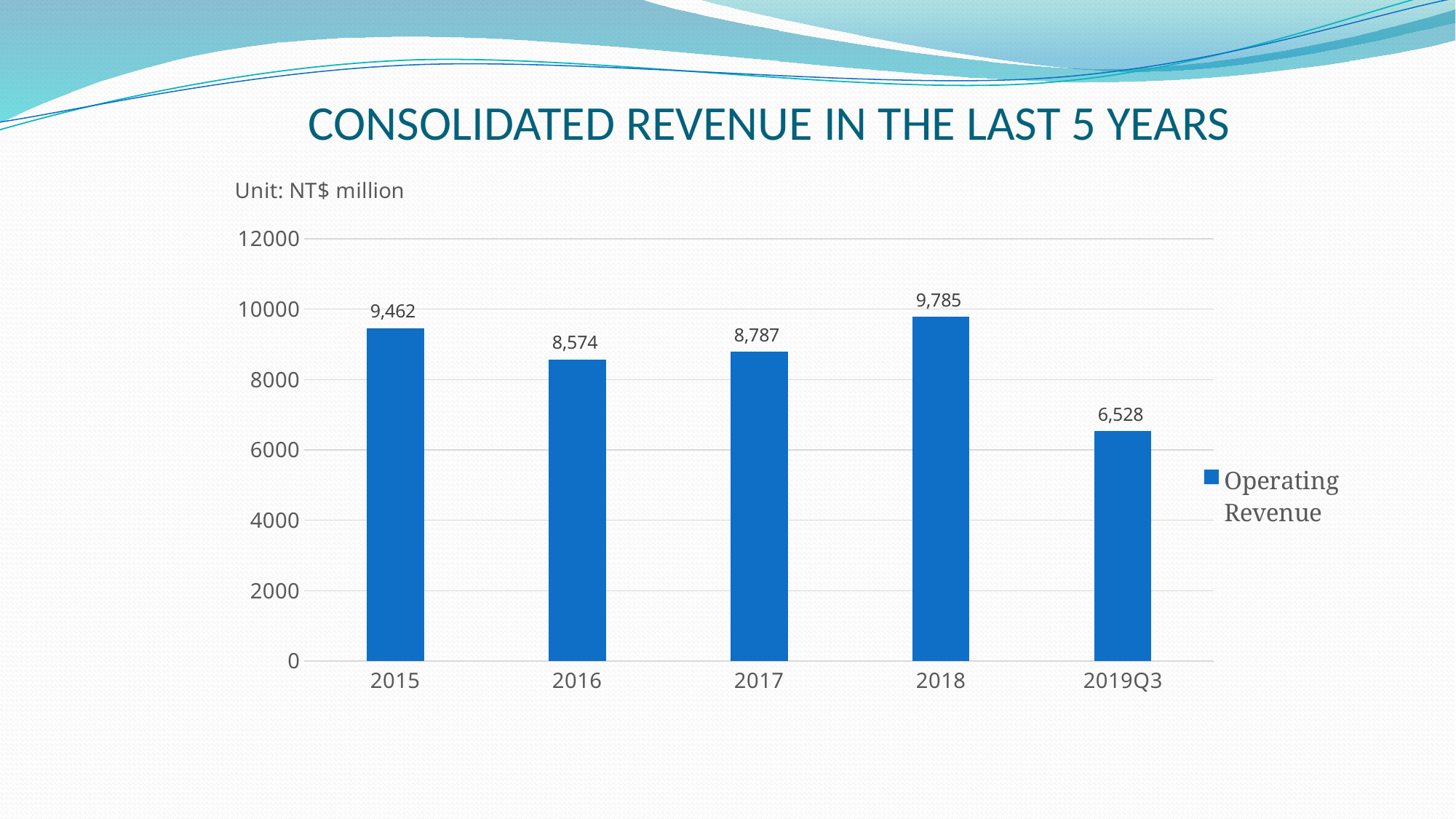
What kind of chart is shown on the slide? Bar chart How many categories are shown on the x axis? 5 Is the value for 2016 greater or less than 8000? greater What is the Operating Revenue for 2019Q3? 6,528 Which is larger, the Operating Revenue for 2015 or for 2017? 2015 What unit is stated for the values in the chart? NT$ million Which category has the lowest Operating Revenue? 2019Q3 What is the difference in Operating Revenue between 2018 and 2016? 1,211 What is the Operating Revenue for 2017? 8,787 What is the Operating Revenue for 2015? 9,462 How many series does the legend list? 1 Which year has the highest Operating Revenue? 2018